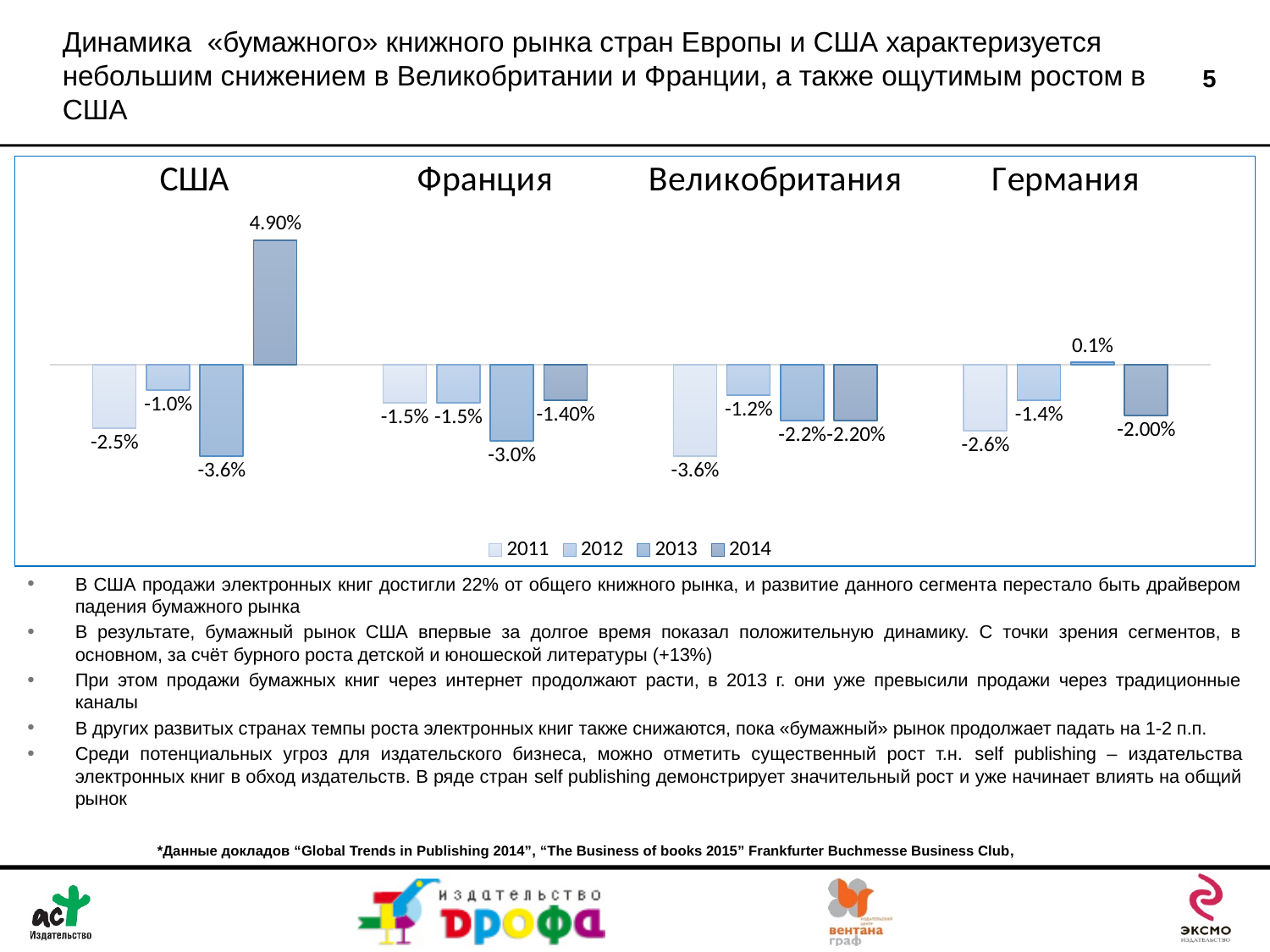
What is the difference between the 2014 and 2013 values for США? 8.5 percentage points Which year has the lowest value for США? 2013 How many series does the legend list? 4 Which country has the highest value in 2014? США What is the value for Германия in 2013? 0.1% What is the value for Великобритания in 2011? -3.6% Which is larger, the 2012 value for Франция or the 2012 value for Великобритания? Великобритания (-1.2%) What is the value for США in 2014? 4.90% How many countries are shown in the chart? 4 What is the value for Германия in 2014? -2.00% What kind of chart is shown on the slide? Bar chart What is the value for Франция in 2013? -3.0%